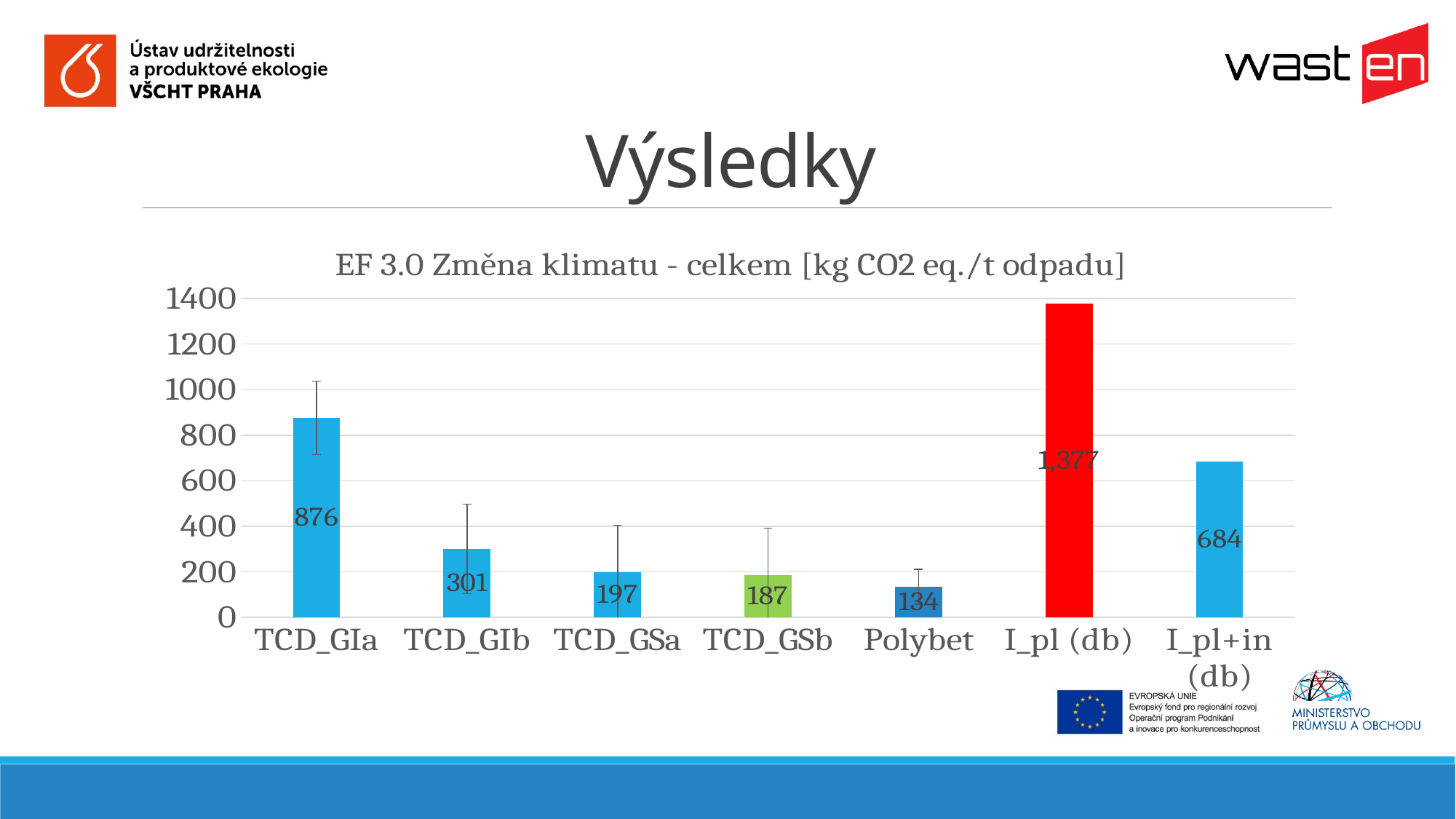
What is the value for Polybet? 134 What is the difference between the values for TCD_GIb and TCD_GSa? 104 Which is larger, the value for TCD_GIa or the value for I_pl+in (db)? TCD_GIa What is the value for TCD_GIa? 876 What kind of chart is shown on the slide? bar chart Which category has the highest value? I_pl (db) What is the value for I_pl (db)? 1,377 How many categories are shown on the x axis? 7 What is the difference between the values for I_pl (db) and I_pl+in (db)? 693 Which category has the lowest value? Polybet What is the value for I_pl+in (db)? 684 What is the title of the chart? EF 3.0 Změna klimatu - celkem [kg CO2 eq./t odpadu]